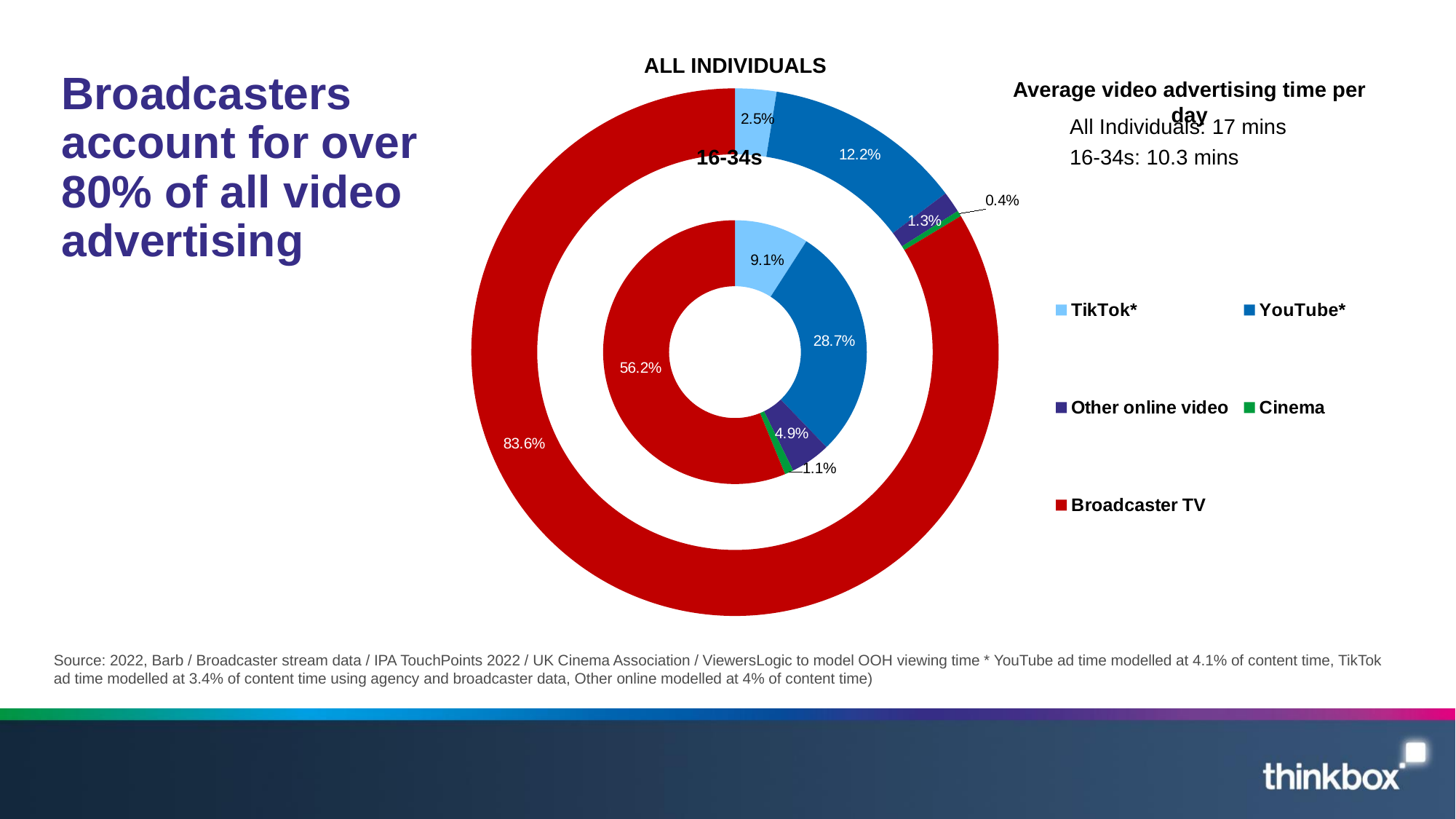
In the ALL INDIVIDUALS ring, what share does Broadcaster TV account for? 83.6% Which is larger: the YouTube* share for 16-34s or the YouTube* share for ALL INDIVIDUALS? 16-34s Which ring of the doughnut chart represents 16-34s, the inner or the outer? Inner In the ALL INDIVIDUALS ring, what is the value for Cinema? 0.4% What is the difference between the Other online video share for 16-34s and for ALL INDIVIDUALS? 3.6% In the 16-34s ring, what is the value for TikTok*? 9.1% What kind of chart is shown on the slide? Doughnut chart In the 16-34s ring, what share does YouTube* account for? 28.7% Which category has the largest share in the 16-34s ring? Broadcaster TV How many series does the legend list? 5 What is the difference between the Broadcaster TV share for ALL INDIVIDUALS and for 16-34s? 27.4% Which category has the smallest share in the ALL INDIVIDUALS ring? Cinema